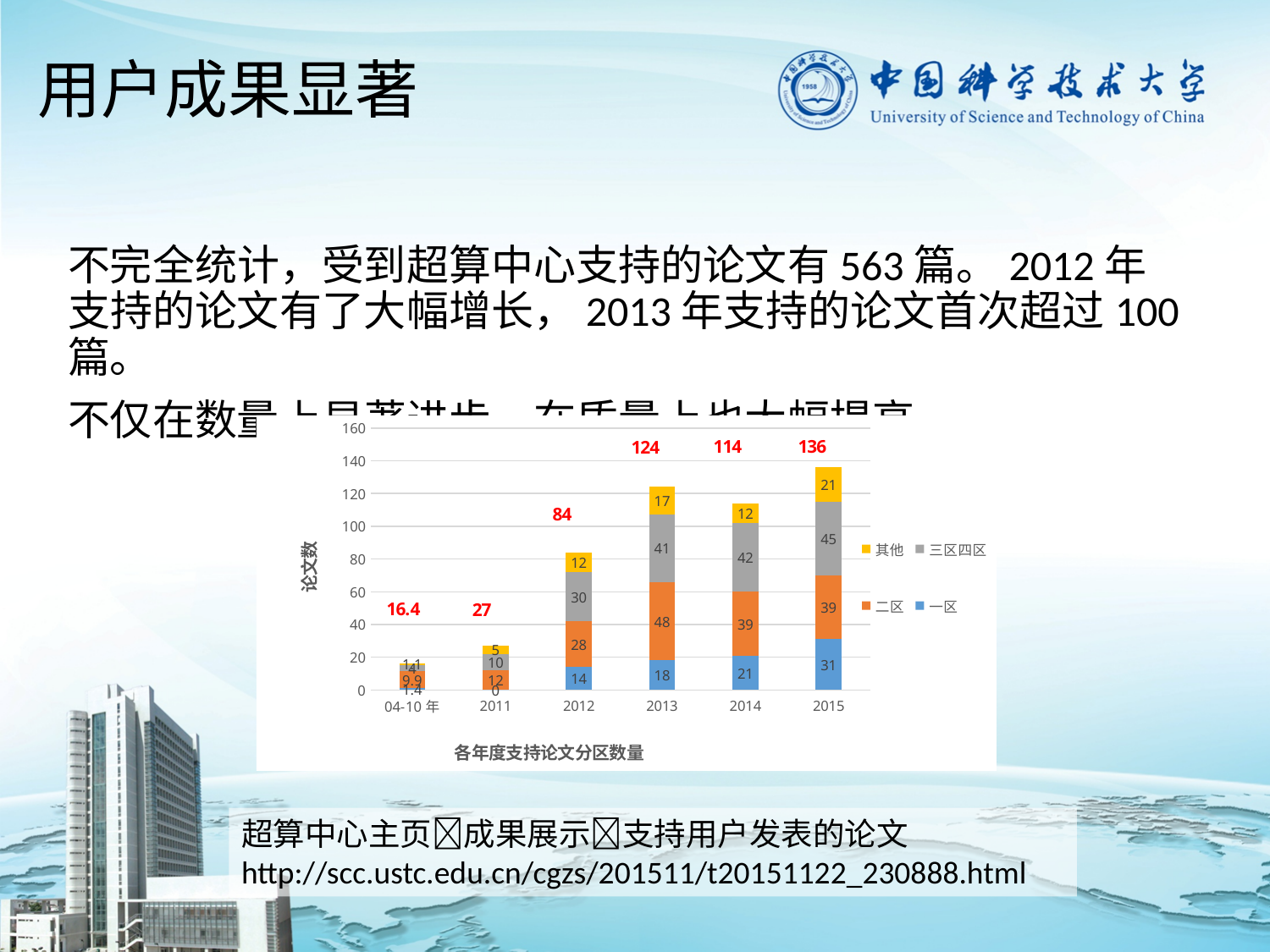
How many series does the chart legend list? 4 Which year has the highest total number of papers? 2015 What kind of chart is shown on the slide? stacked bar chart Is the total for 2012 greater or less than 100? less How many categories are shown on the x axis of the chart? 6 What is the value of 二区 for 2013? 48 What is the difference between the totals for 2015 and 2014? 22 What is the value of 一区 for 2015? 31 What is the value of 其他 for 2012? 12 What is the value of 三区四区 for 2014? 42 What is the total number of papers shown for 2013? 124 What is the title of the chart? 各年度支持论文分区数量